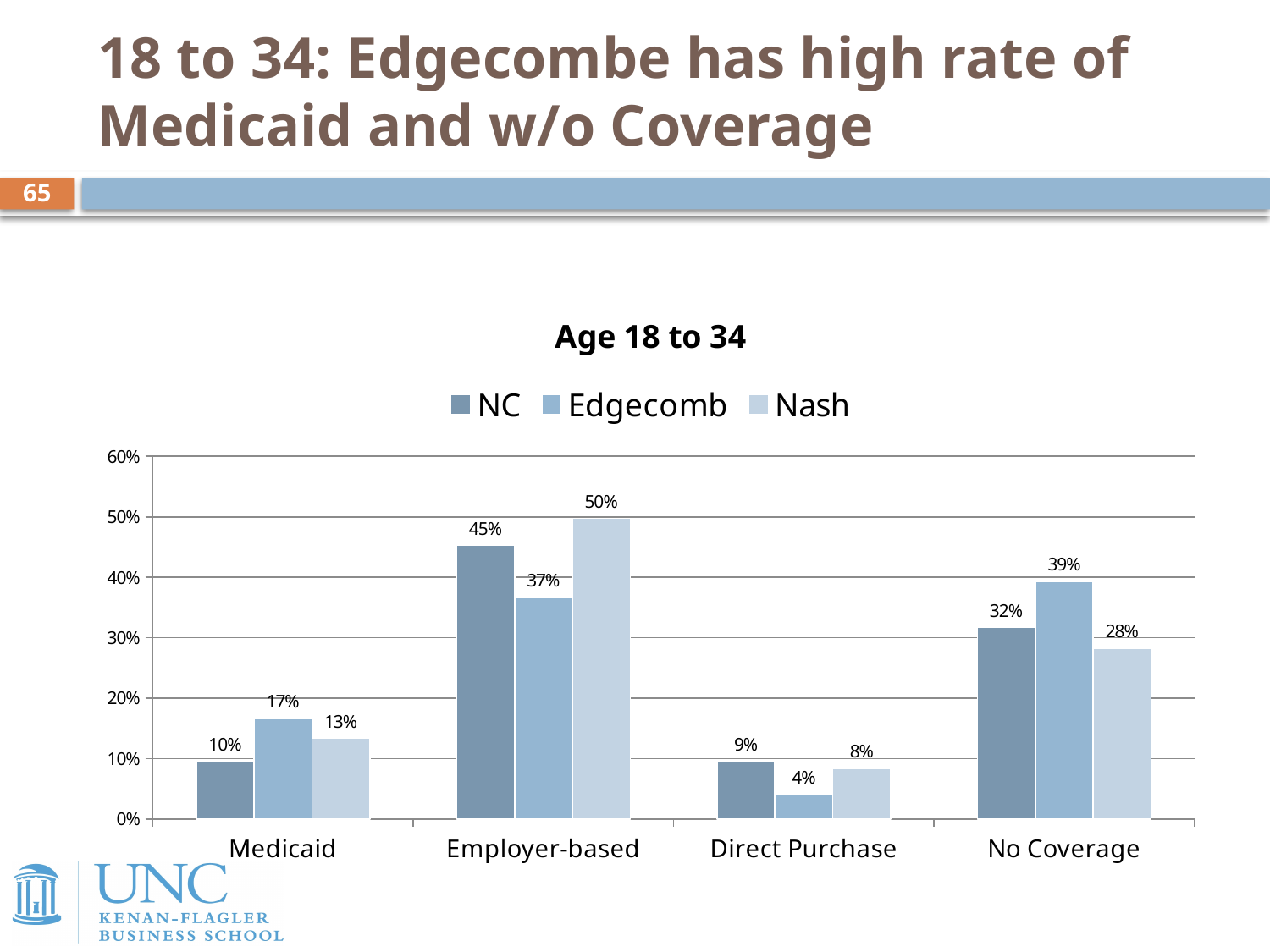
What is the title of the chart? Age 18 to 34 What is the NC value for No Coverage? 32% How many series does the legend list? 3 Which category has the highest Edgecomb value? Employer-based What is the Edgecomb value for Direct Purchase? 4% Which is larger for No Coverage, the Edgecomb value or the Nash value? Edgecomb What is the Nash value for Employer-based coverage? 50% Which category has the lowest Nash value? Direct Purchase What is the Edgecomb value for Medicaid? 17% How many categories are shown on the x axis? 4 What kind of chart is shown on the slide? Bar chart What is the difference between the NC and Edgecomb values for Employer-based coverage? 8%